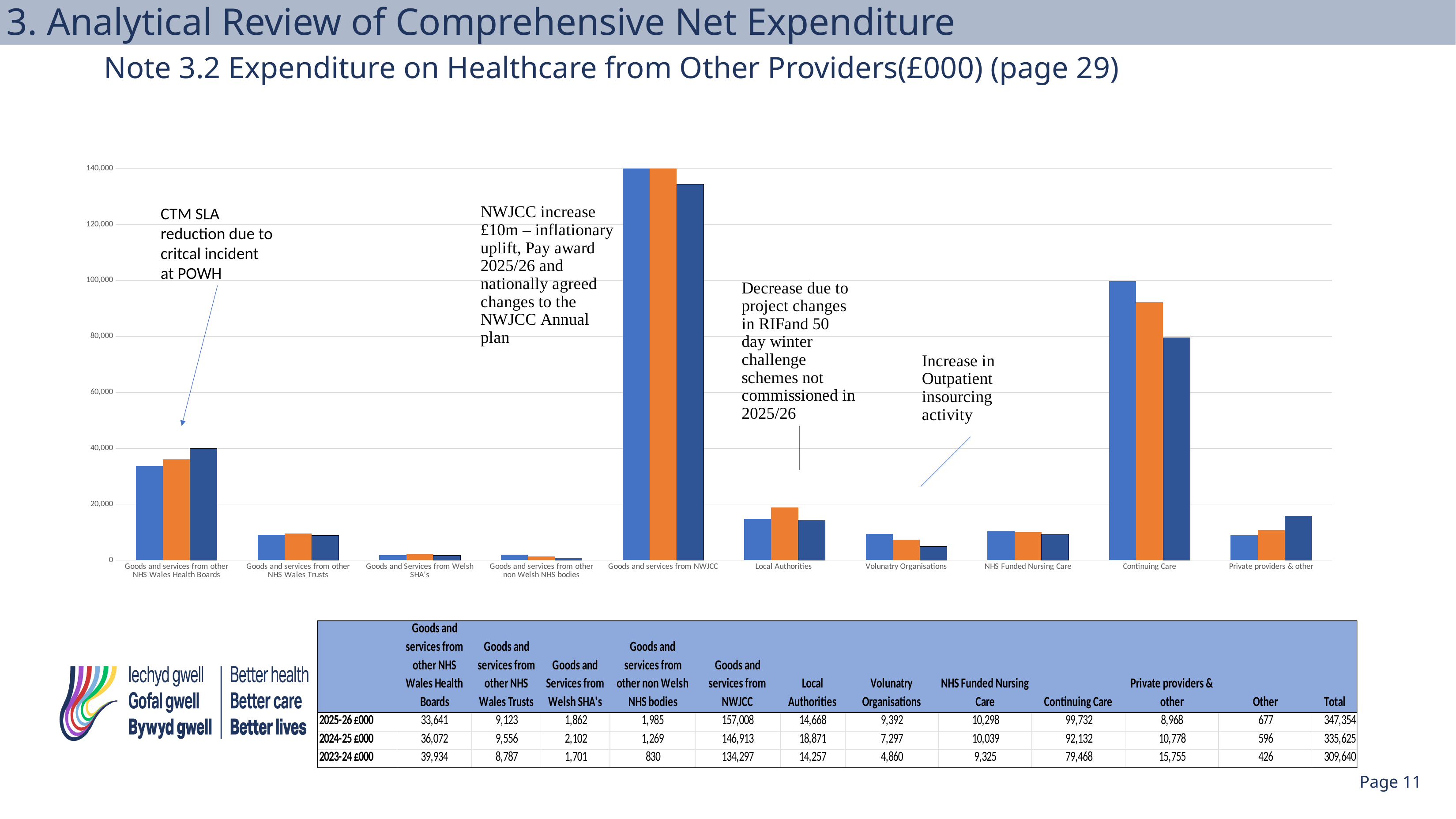
Which category does the annotation 'CTM SLA reduction due to critcal incident at POWH' point to? Goods and services from other NHS Wales Health Boards What kind of chart is shown on the slide? Bar chart Is the tallest bar for Continuing Care greater or less than 80,000? greater Is the tallest bar for Local Authorities greater or less than 20,000? less Which category has taller bars, Continuing Care or Local Authorities? Continuing Care What is the highest value labelled on the chart's vertical axis? 140,000 Which category has the tallest bars in the chart? Goods and services from NWJCC How many categories are shown along the x axis of the chart? 10 According to the table below the chart, what is the 2025-26 value for Continuing Care? 99,732 According to the table below the chart, what is the 2025-26 Total? 347,354 Within the Continuing Care group, do the bars get taller or shorter from left to right? shorter Using the table values, what is the difference between the 2025-26 and 2024-25 values for Goods and services from NWJCC? 10,095